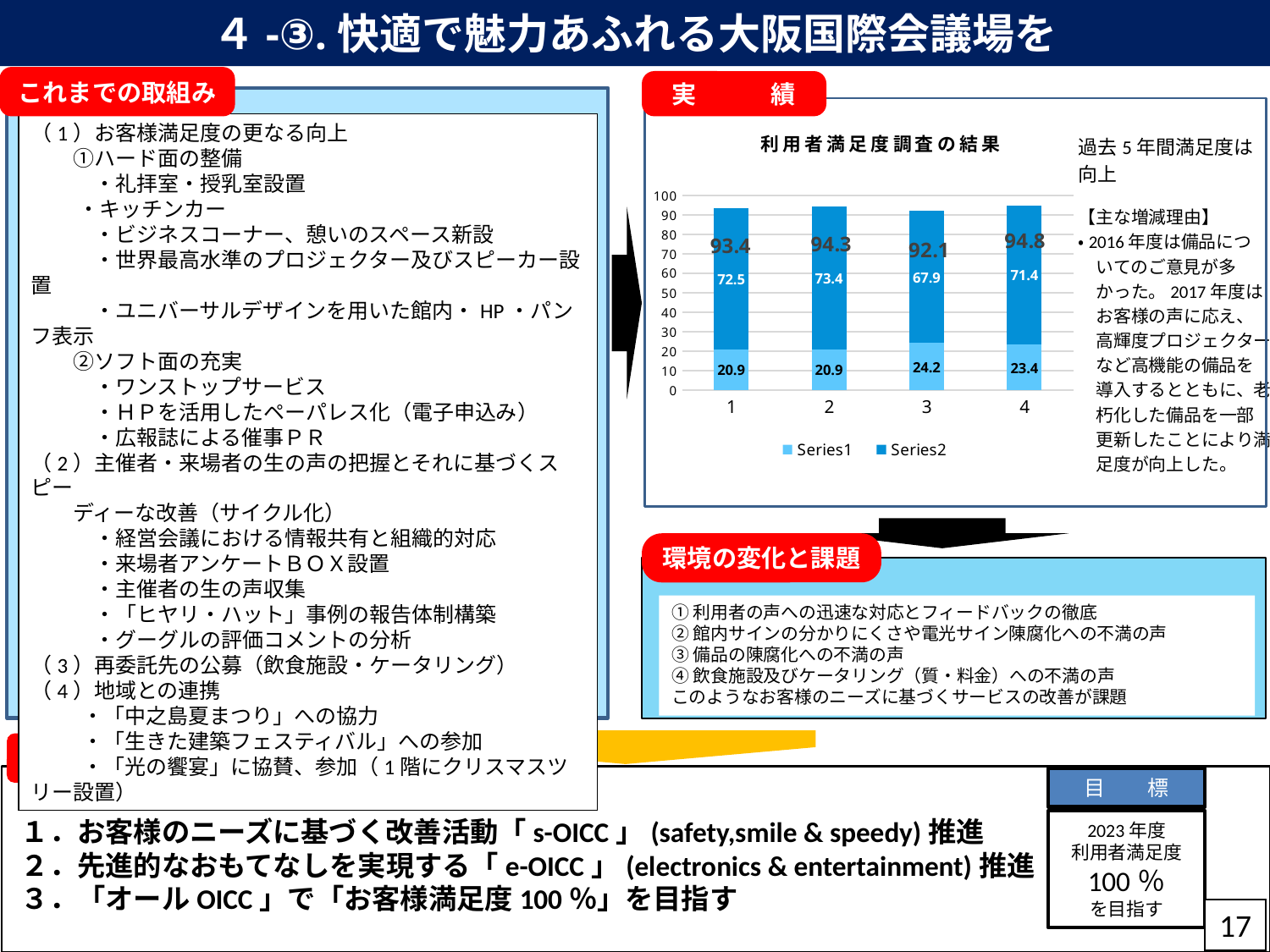
What type of chart is shown under 利用者満足度調査の結果? stacked bar chart What is the total of the stacked bar for category 4? 94.8 How many categories are shown on the x axis of the chart? 4 What is the Series1 value for category 3? 24.2 Which category has the highest Series1 value? 3 Which category has the lowest Series2 value? 3 What is the title of the chart? 利用者満足度調査の結果 Is the Series2 value for category 4 greater or less than 70? greater What is the Series1 value for category 1? 20.9 How many series does the chart legend list? 2 What is the difference between the Series2 values for category 2 and category 3? 5.5 What is the Series2 value for category 2? 73.4